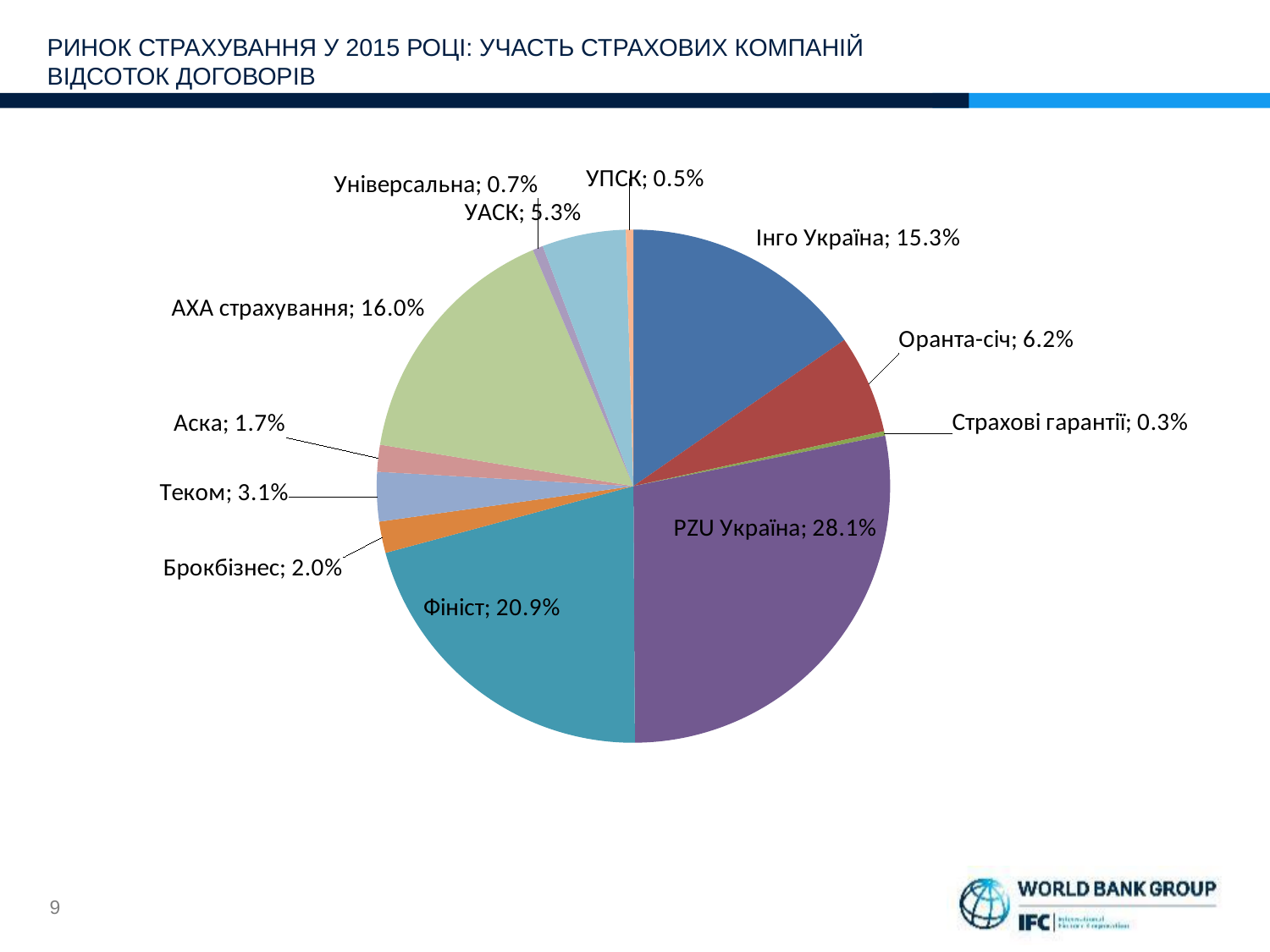
Which is larger, the share of Теком or the share of Брокбізнес? Теком What share of the pie does PZU Україна hold? 28.1% What is the combined share of УАСК, Універсальна and УПСК? 6.5% What kind of chart is shown on the slide? Pie chart Which company has the largest slice of the pie? PZU Україна What is the value shown for Фініст? 20.9% What percentage is labelled for АХА страхування? 16.0% What is the value for Оранта-січ? 6.2% What is the difference between the shares of PZU Україна and Фініст? 7.2% Which company has the smallest slice of the pie? Страхові гарантії What is the difference between the shares of АХА страхування and Інго Україна? 0.7% How many companies (slices) are shown in the pie chart? 12